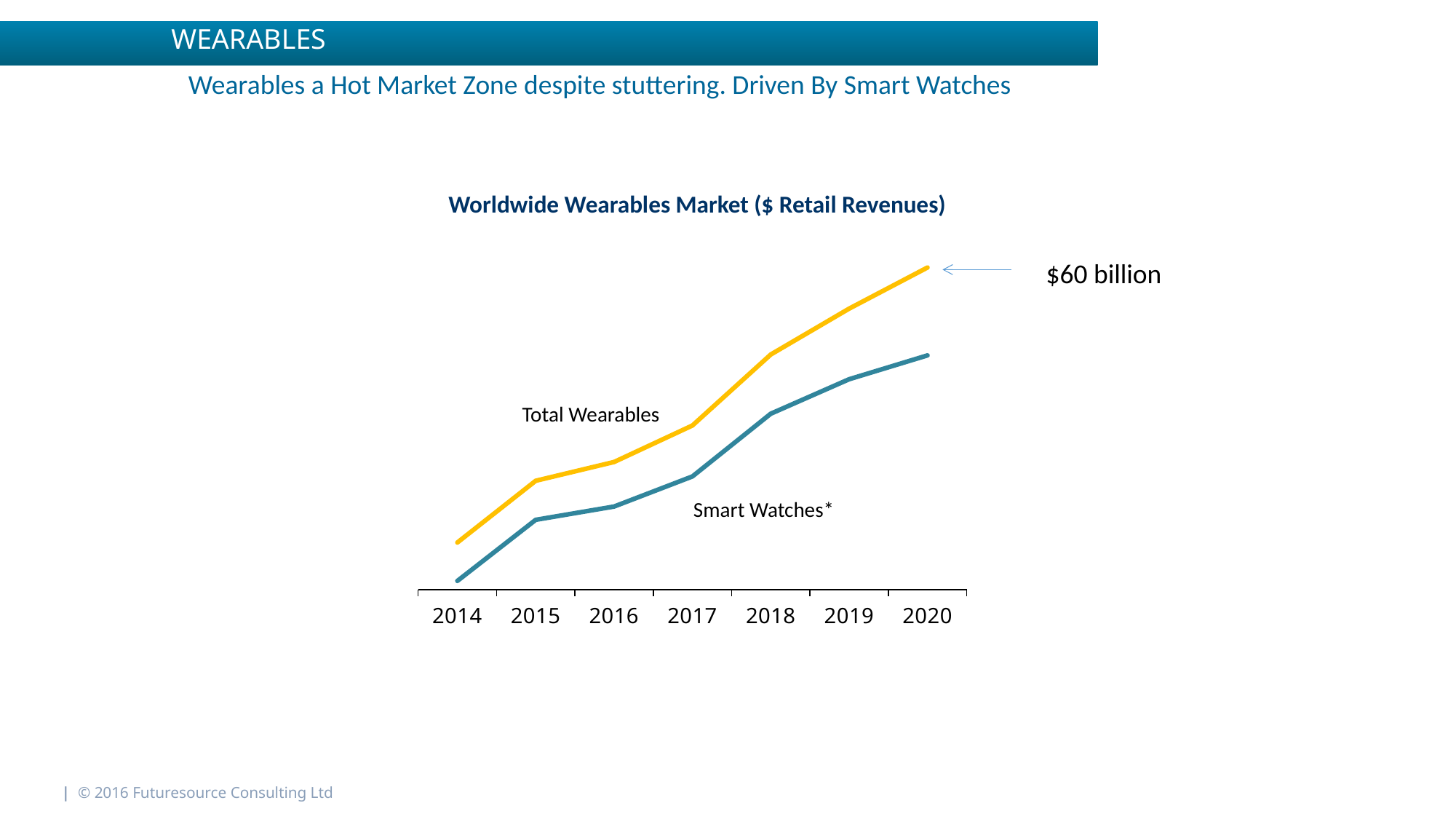
What is the first year shown on the x axis? 2014 In which year is the Smart Watches* value lowest? 2014 In 2018, which series has the larger value, Total Wearables or Smart Watches*? Total Wearables What value is annotated for Total Wearables in 2020? $60 billion In which year is the Total Wearables value highest? 2020 Do the Smart Watches* values rise or fall from 2014 to 2020? Rise Do the Total Wearables values rise or fall from 2014 to 2020? Rise What kind of chart is shown on the slide? Line chart What is the title of the chart? Worldwide Wearables Market ($ Retail Revenues) Which series is drawn in yellow? Total Wearables How many series are plotted on the chart? 2 How many years are shown on the x axis of the chart? 7